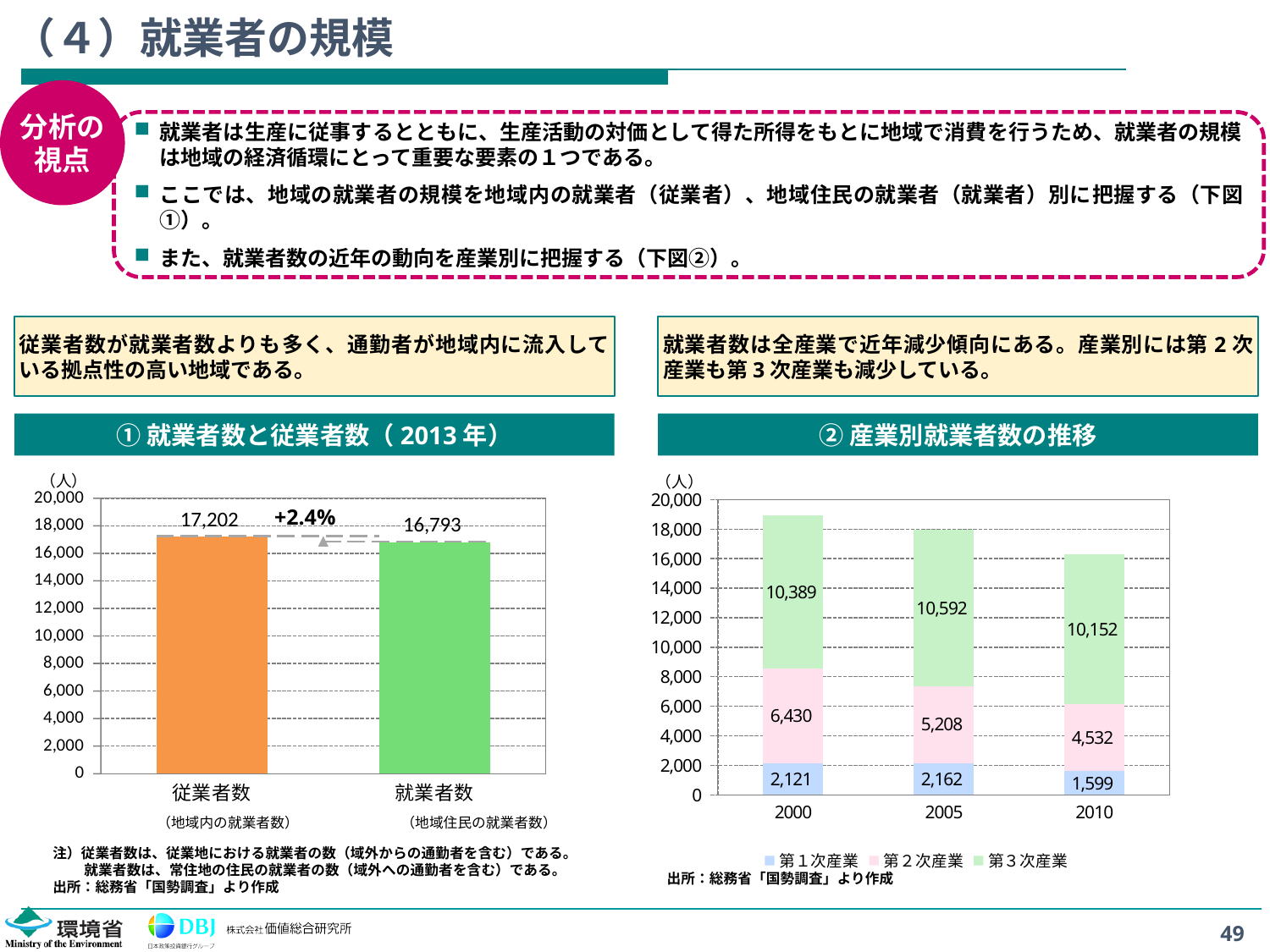
In the chart titled ② 産業別就業者数の推移, what is the value for 第２次産業 in 2005? 5,208 In the chart titled ② 産業別就業者数の推移, what is the total of the stacked bar for 2010? 16,283 In the chart titled ② 産業別就業者数の推移, what is the value for 第１次産業 in 2010? 1,599 In the chart titled ② 産業別就業者数の推移, which year has the highest value for 第３次産業? 2005 In the chart titled ① 就業者数と従業者数（2013年）, what is the difference between 従業者数 and 就業者数? 409 In the chart titled ① 就業者数と従業者数（2013年）, what is the value for 就業者数? 16,793 In the chart titled ② 産業別就業者数の推移, how many series does the legend list? 3 In the chart titled ② 産業別就業者数の推移, do the total bar heights rise or fall from 2000 to 2010? Fall In the chart titled ② 産業別就業者数の推移, what is the total of the stacked bar for 2000? 18,940 In the chart titled ① 就業者数と従業者数（2013年）, what percentage label is shown between the two bars? +2.4% In the chart titled ① 就業者数と従業者数（2013年）, what is the value for 従業者数? 17,202 What kind of chart is the chart titled ② 産業別就業者数の推移? Stacked bar chart